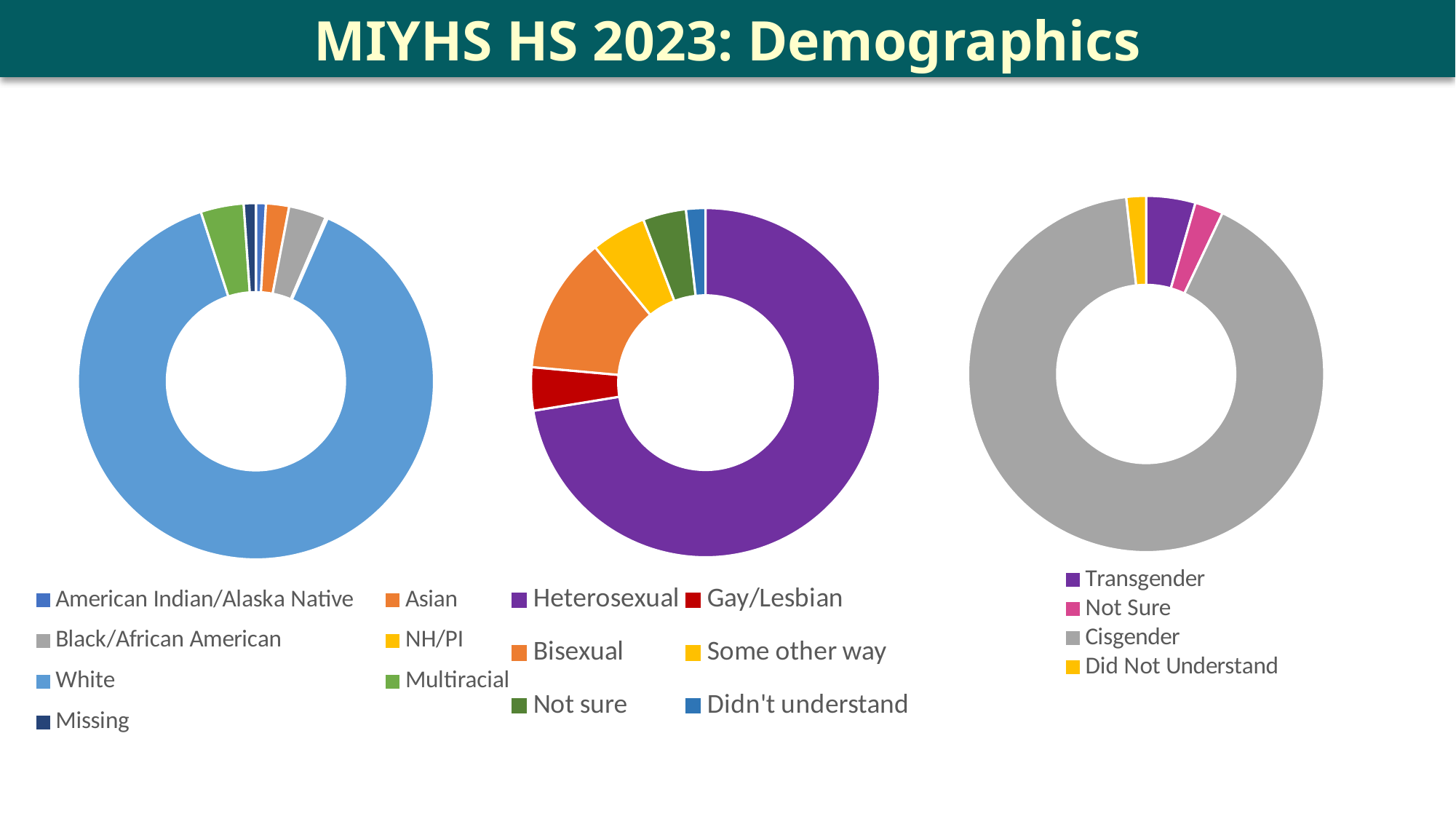
In the middle chart, which is larger, the Some other way slice or the Didn't understand slice? Some other way In the left chart, which is larger, the Multiracial slice or the Asian slice? Multiracial How many categories does the legend of the left chart list? 7 In the left chart, which category has the largest slice? White In the middle chart, which is larger, the Bisexual slice or the Gay/Lesbian slice? Bisexual How many categories does the legend of the middle chart list? 6 In the middle chart, which category has the largest slice? Heterosexual In the right chart, which category has the largest slice? Cisgender What is the title of the slide? MIYHS HS 2023: Demographics What kind of chart is the left chart on the slide? Doughnut (pie) chart How many categories does the legend of the right chart list? 4